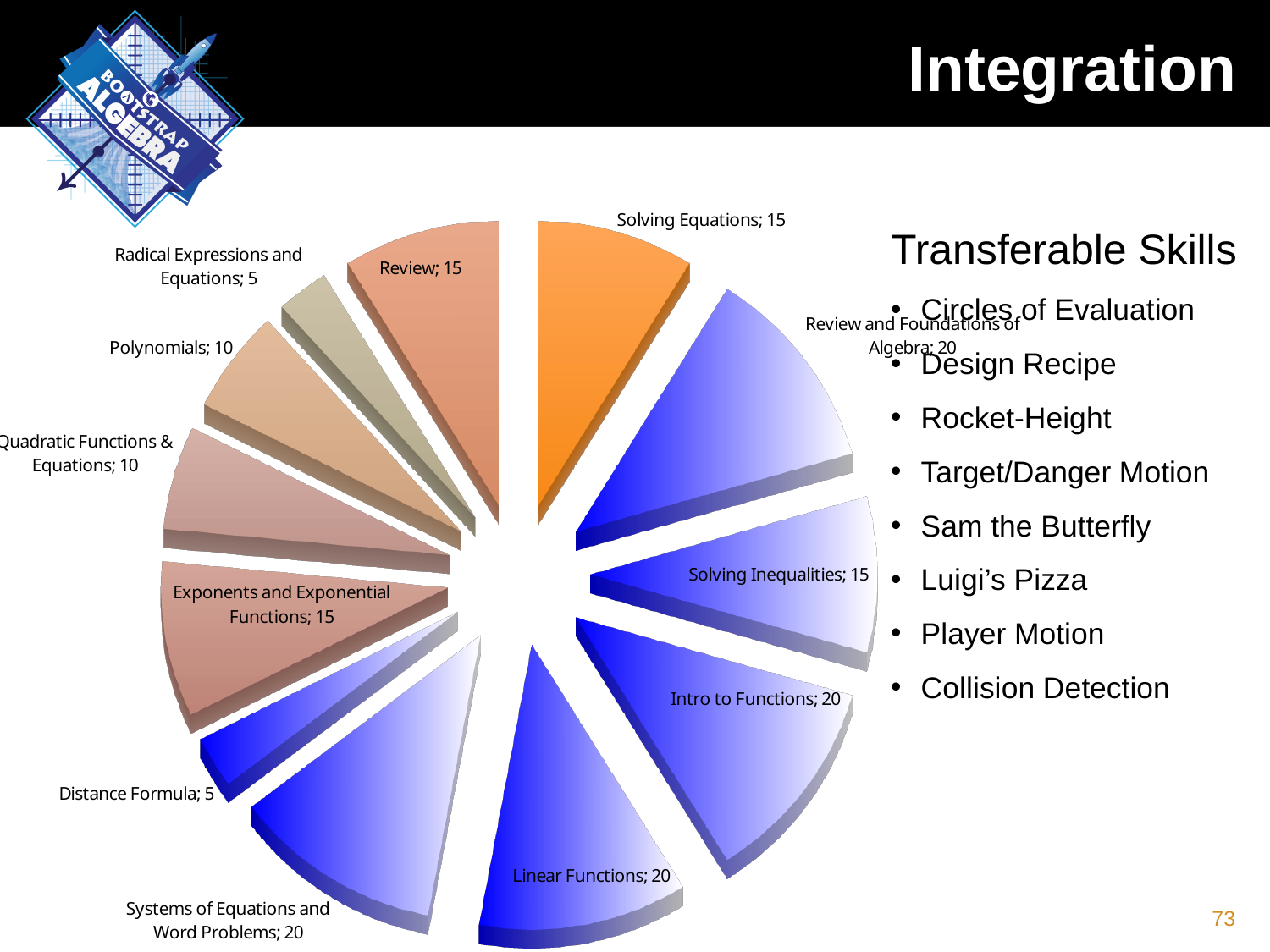
Which is larger, Intro to Functions or Solving Inequalities? Intro to Functions What is the value for Polynomials? 10 What is the value for Distance Formula? 5 What is the value for Review and Foundations of Algebra? 20 What is the difference between the values for Systems of Equations and Word Problems and Distance Formula? 15 How many slices does the pie chart have? 12 What is the difference between the values for Review and Polynomials? 5 What type of chart is shown on the slide? Pie chart What is the largest value shown for any slice in the pie chart? 20 What is the value for Linear Functions? 20 Which is larger, Radical Expressions and Equations or Quadratic Functions & Equations? Quadratic Functions & Equations What is the value for Exponents and Exponential Functions? 15